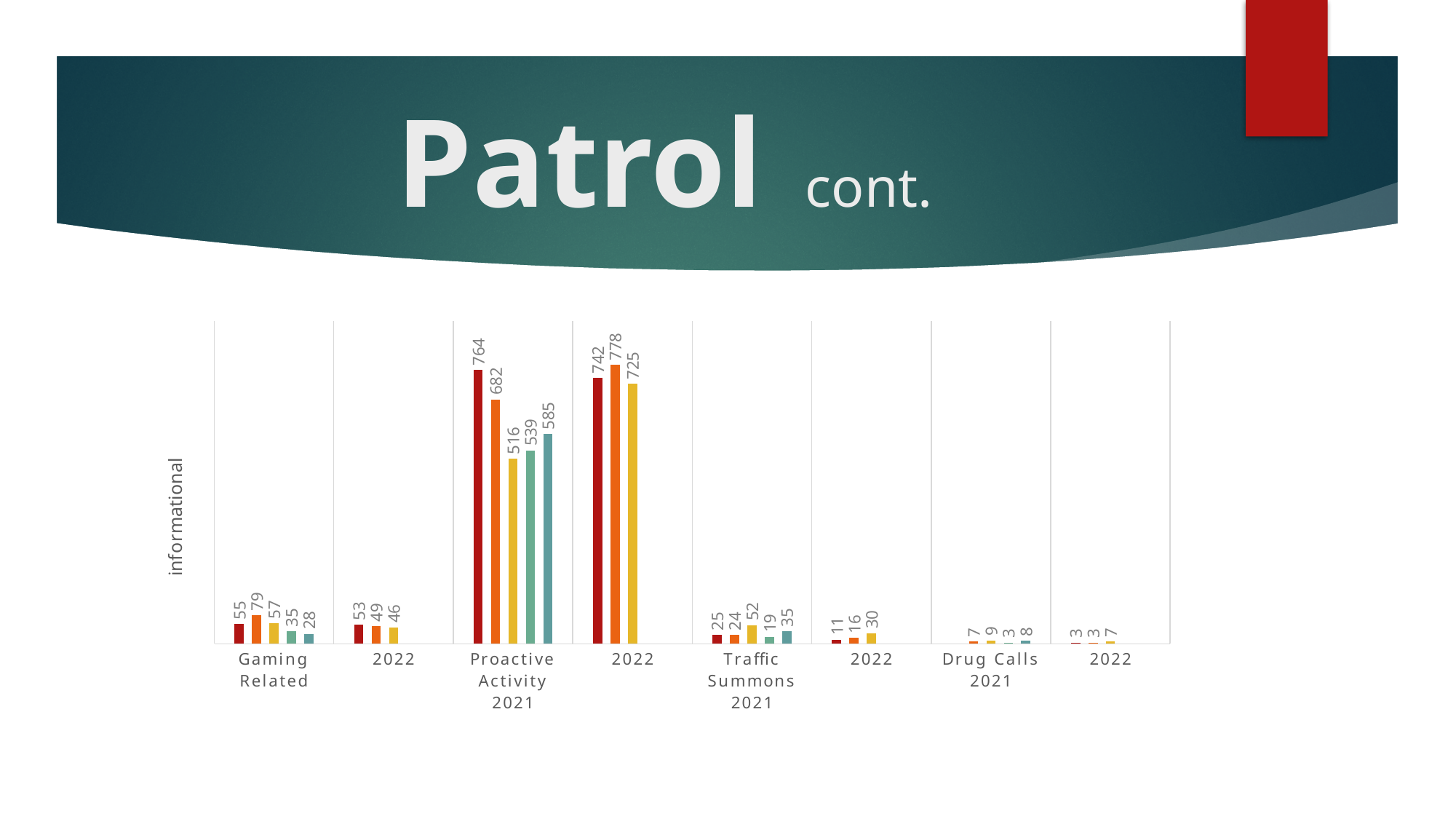
How many bars are in the Gaming Related group? 5 What is the value of the second (orange) bar in the Gaming Related group? 79 What is the value of the first (dark red) bar in the Proactive Activity 2021 group? 764 What is the value of the last (teal) bar in the Proactive Activity 2021 group? 585 How many categories are shown along the x axis of the chart? 8 What is the value of the tallest bar in the Proactive Activity 2022 group? 778 What is the lowest value labelled in the Traffic Summons 2021 group? 19 What type of chart is shown on the slide? bar chart What is the label on the vertical axis of the chart? informational What is the difference between the first bar of Proactive Activity 2021 (764) and the first bar of Proactive Activity 2022 (742)? 22 Which is larger: the third (yellow) bar in Traffic Summons 2021 or the third (yellow) bar in Traffic Summons 2022? Traffic Summons 2021 What is the value of the third (yellow) bar in the Drug Calls 2021 group? 9